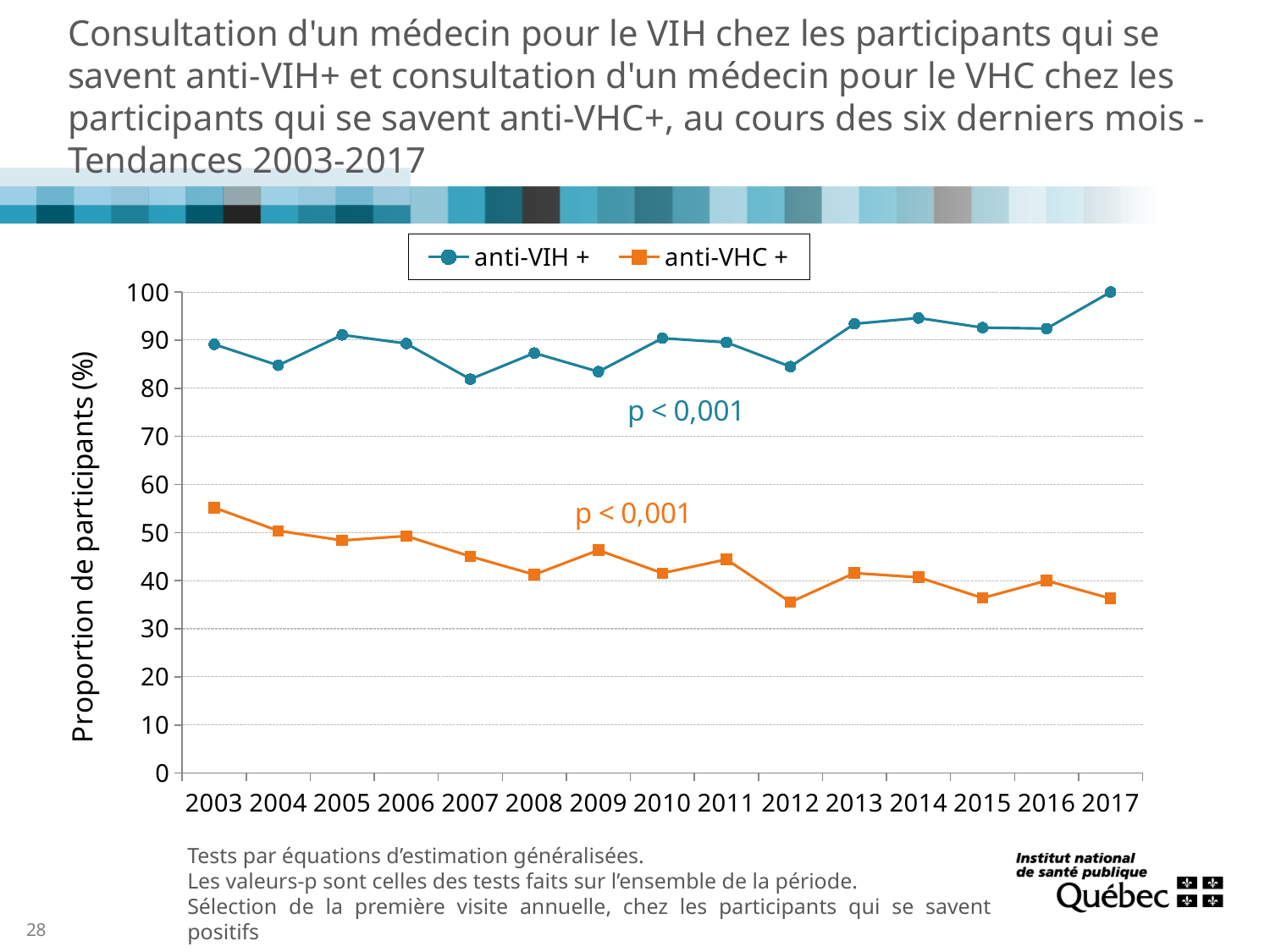
What kind of chart is shown on the slide? line chart Which series has the larger value in 2010, anti-VIH + or anti-VHC +? anti-VIH + What is the value for anti-VIH + in 2017? 100 In which year is the anti-VHC + series at its highest? 2003 In which year is the anti-VIH + series at its highest? 2017 How many years are plotted along the x axis? 15 How many series does the legend list? 2 Is the value for anti-VHC + in 2003 greater or less than 50? greater Is the value for anti-VIH + in 2007 greater or less than 80? greater What is the label of the y axis? Proportion de participants (%) Is the value for anti-VHC + in 2012 greater or less than 40? less Does the anti-VHC + series generally rise or fall from 2003 to 2017? fall